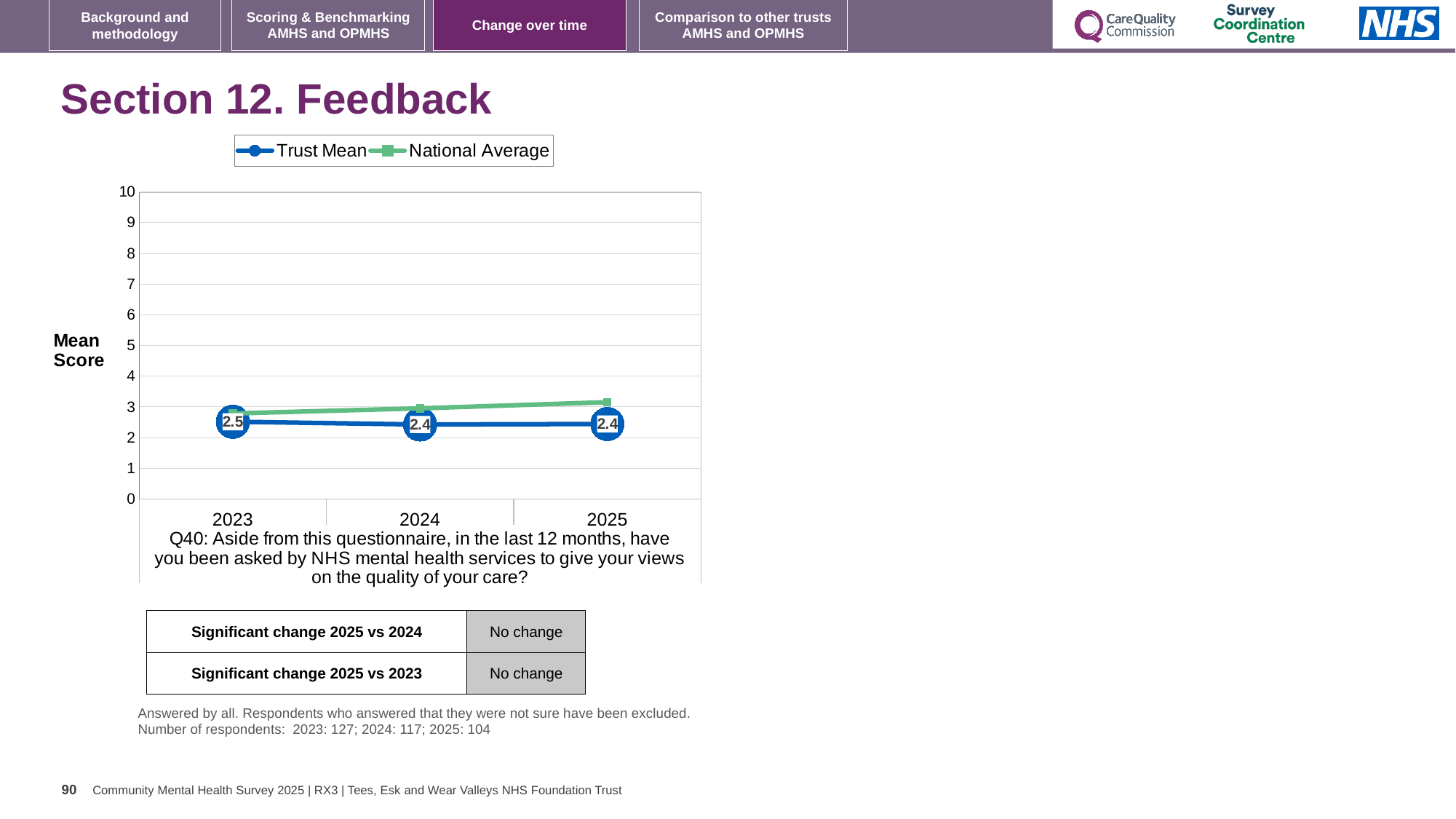
What is the Trust Mean value for 2025? 2.4 What is the difference between the Trust Mean in 2023 and in 2025? 0.1 What is the label on the y axis of the chart? Mean Score What kind of chart is shown on the slide? Line chart What is the Trust Mean value for 2024? 2.4 How many series does the legend list? 2 What is the Trust Mean value for 2023? 2.5 How many years are plotted on the x axis? 3 Does the National Average rise or fall from 2023 to 2025? Rise In which year is the Trust Mean highest? 2023 In 2025, which is larger: the Trust Mean or the National Average? National Average Is the National Average value for 2025 greater or less than 4? less